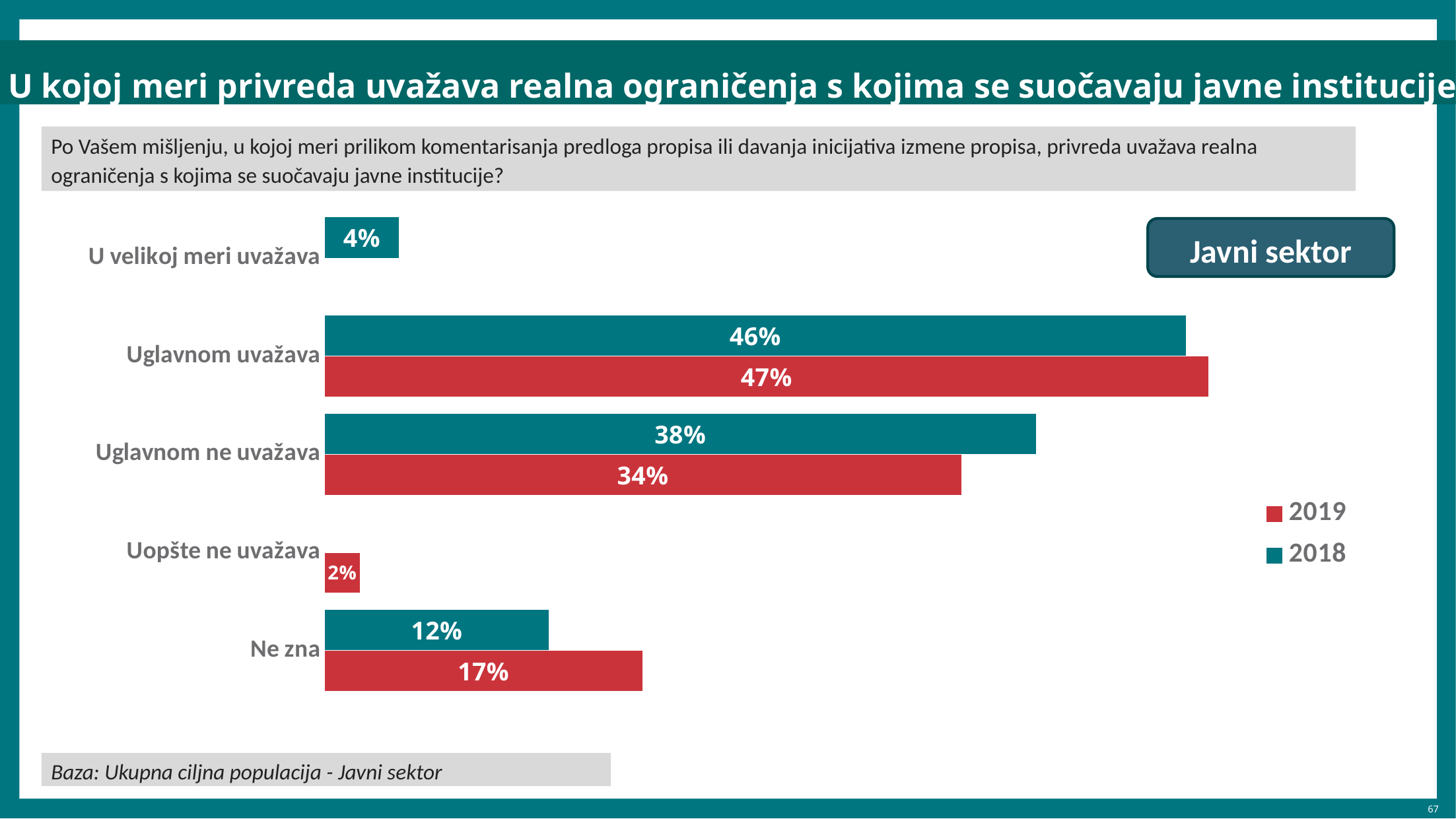
How many series does the legend list? 2 Which category has the lowest 2018 value? U velikoj meri uvažava What type of chart is shown on the slide? Bar chart What is the 2018 value for "U velikoj meri uvažava"? 4% What is the 2019 value for "Uopšte ne uvažava"? 2% What is the 2018 value for "Uglavnom uvažava"? 46% What is the 2019 value for "Ne zna"? 17% Which category has the highest 2019 value? Uglavnom uvažava What is the difference between the 2018 and 2019 values for "Uglavnom ne uvažava"? 4% Which is larger for "Ne zna": the 2018 value or the 2019 value? 2019 How many categories are shown on the chart? 5 What is the 2019 value for "Uglavnom ne uvažava"? 34%